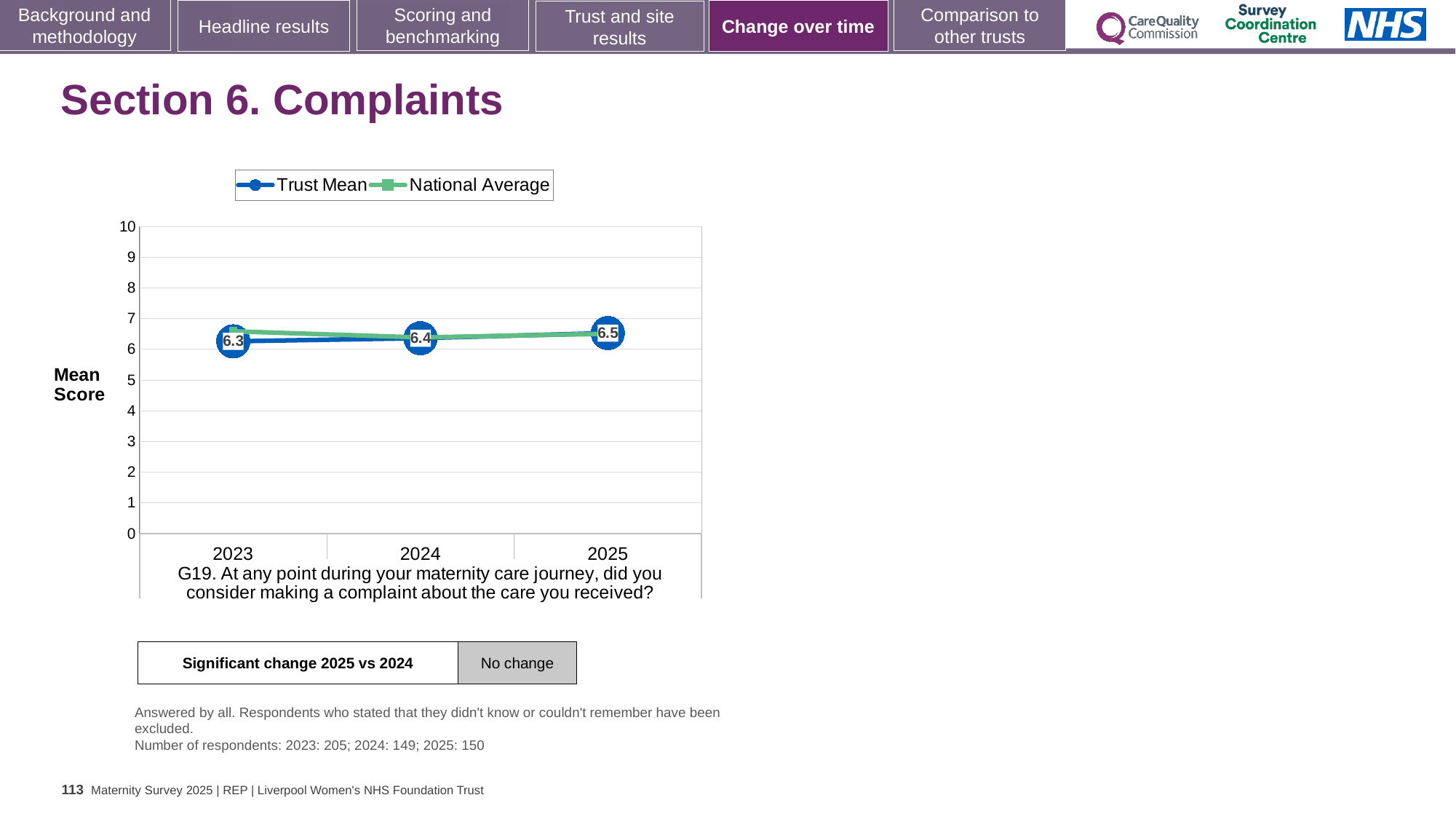
What is the Trust Mean score for 2024? 6.4 What is the difference between the Trust Mean score in 2025 and in 2023? 0.2 Is the National Average value for 2025 greater or less than 7? less In which year is the Trust Mean score lowest? 2023 Which is larger, the Trust Mean score in 2024 or in 2025? 2025 In which year is the Trust Mean score highest? 2025 What is the Trust Mean score for 2025? 6.5 What is the Trust Mean score for 2023? 6.3 What kind of chart is shown on the slide? Line chart Is the National Average value for 2023 greater or less than 6? greater How many series does the legend list? 2 How many years are plotted on the x axis? 3